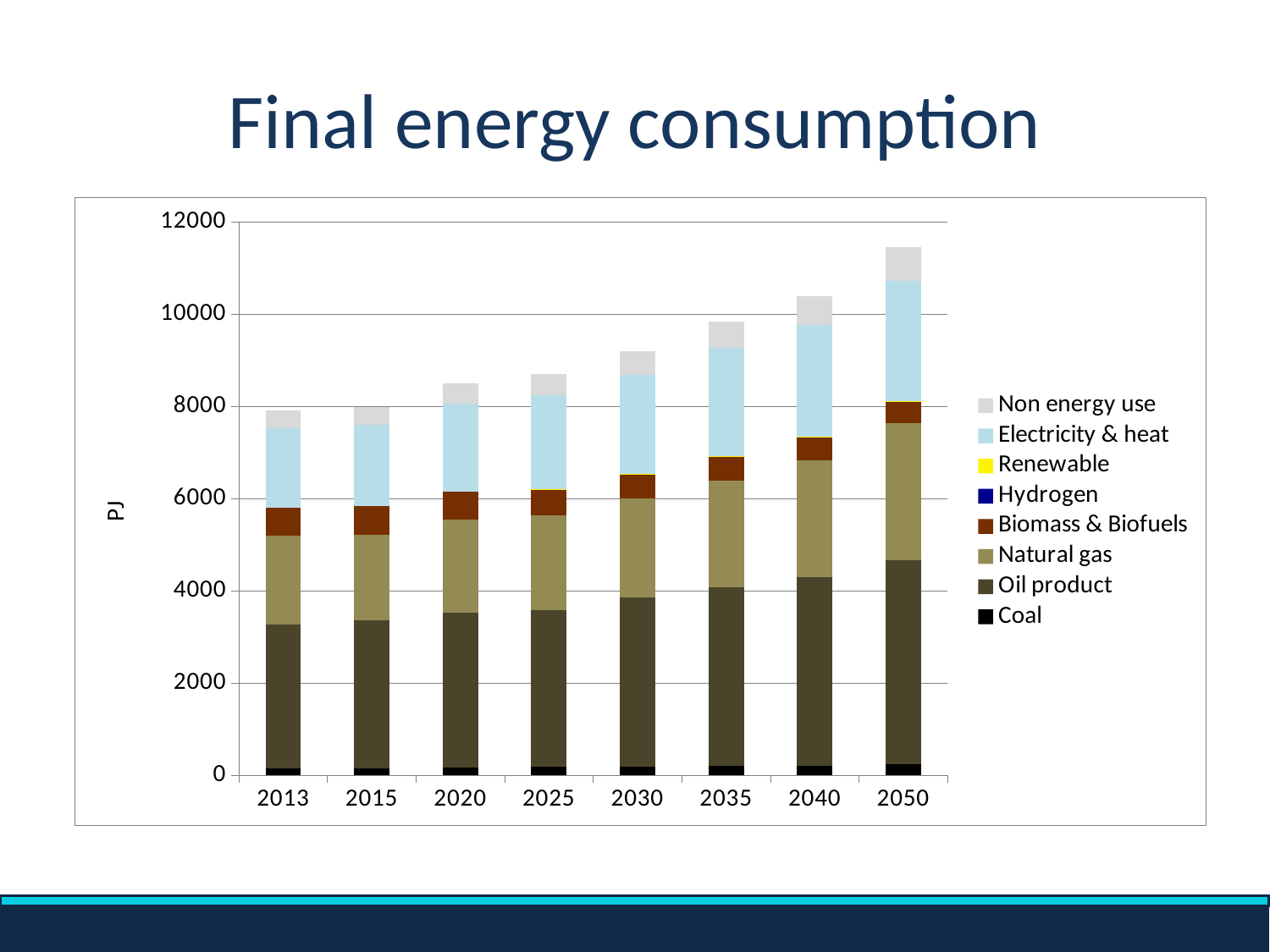
How many series does the legend list? 8 Is the total bar height for 2030 greater or less than 8000? greater How many years are shown on the x axis? 8 What is the label on the y axis? PJ Which is larger, the total bar for 2040 or the total bar for 2020? 2040 Is the total bar height for 2013 greater or less than 10000? less Is the total bar height for 2025 greater or less than 10000? less What kind of chart is shown on the slide? Stacked bar chart Which year has the tallest stacked bar? 2050 Do the total bar heights rise or fall from 2013 to 2050? Rise What is the title of the slide? Final energy consumption